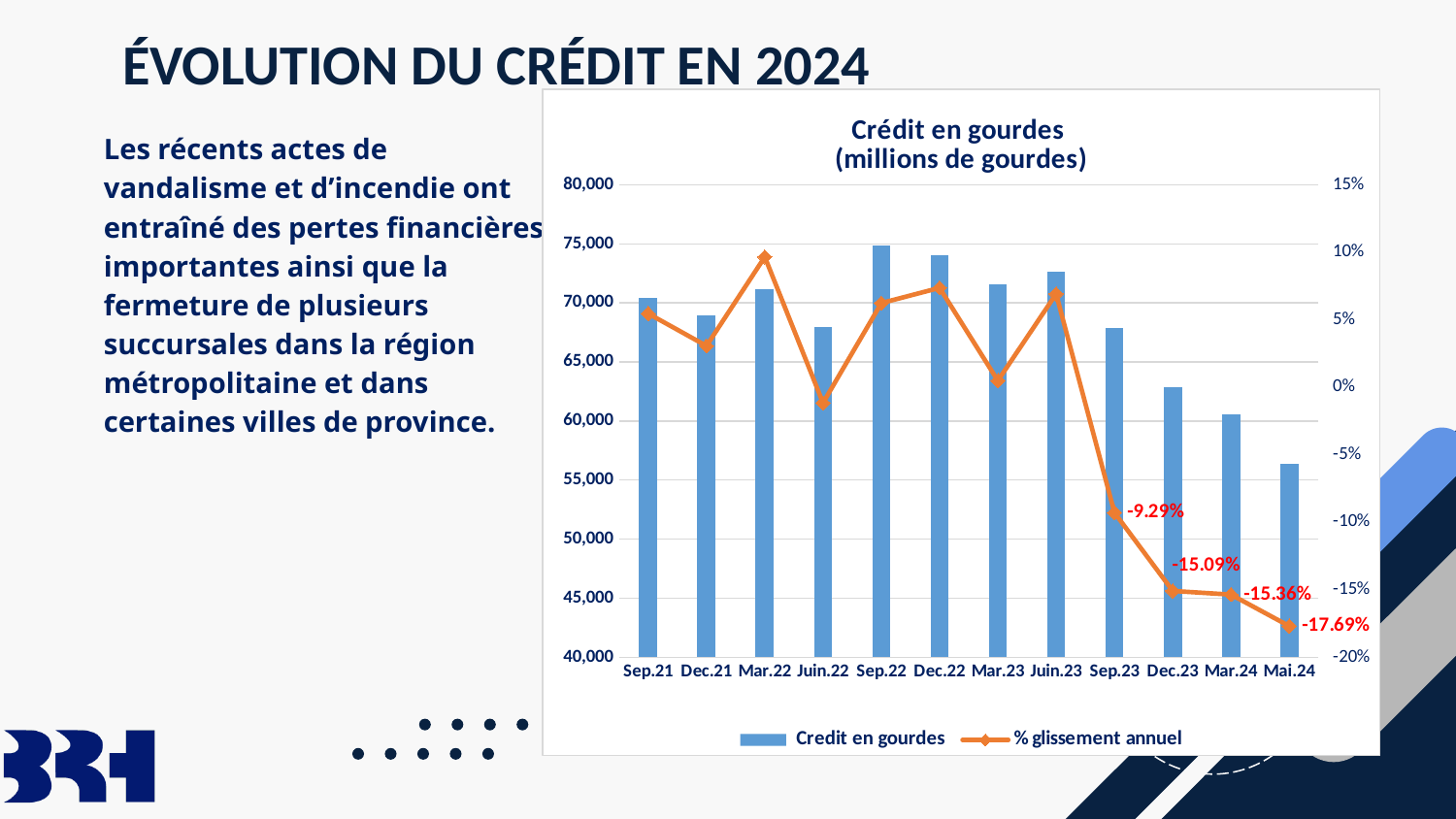
Is the Credit en gourdes value for Sep.22 greater or less than 70,000? greater Which period has the lowest Credit en gourdes bar? Mai.24 What is the difference between the % glissement annuel values for Dec.23 and Mar.24? 0.27 percentage points Is the Credit en gourdes value for Mai.24 greater or less than 60,000? less How many series does the legend list? 2 Which period has the highest % glissement annuel value? Mar.22 How many periods are shown on the x axis? 12 What is the % glissement annuel value for Mai.24? -17.69% What is the % glissement annuel value for Sep.23? -9.29% Which period has the lowest % glissement annuel value? Mai.24 Do the Credit en gourdes bars rise or fall from Juin.23 to Mai.24? fall What is the % glissement annuel value for Dec.23? -15.09%